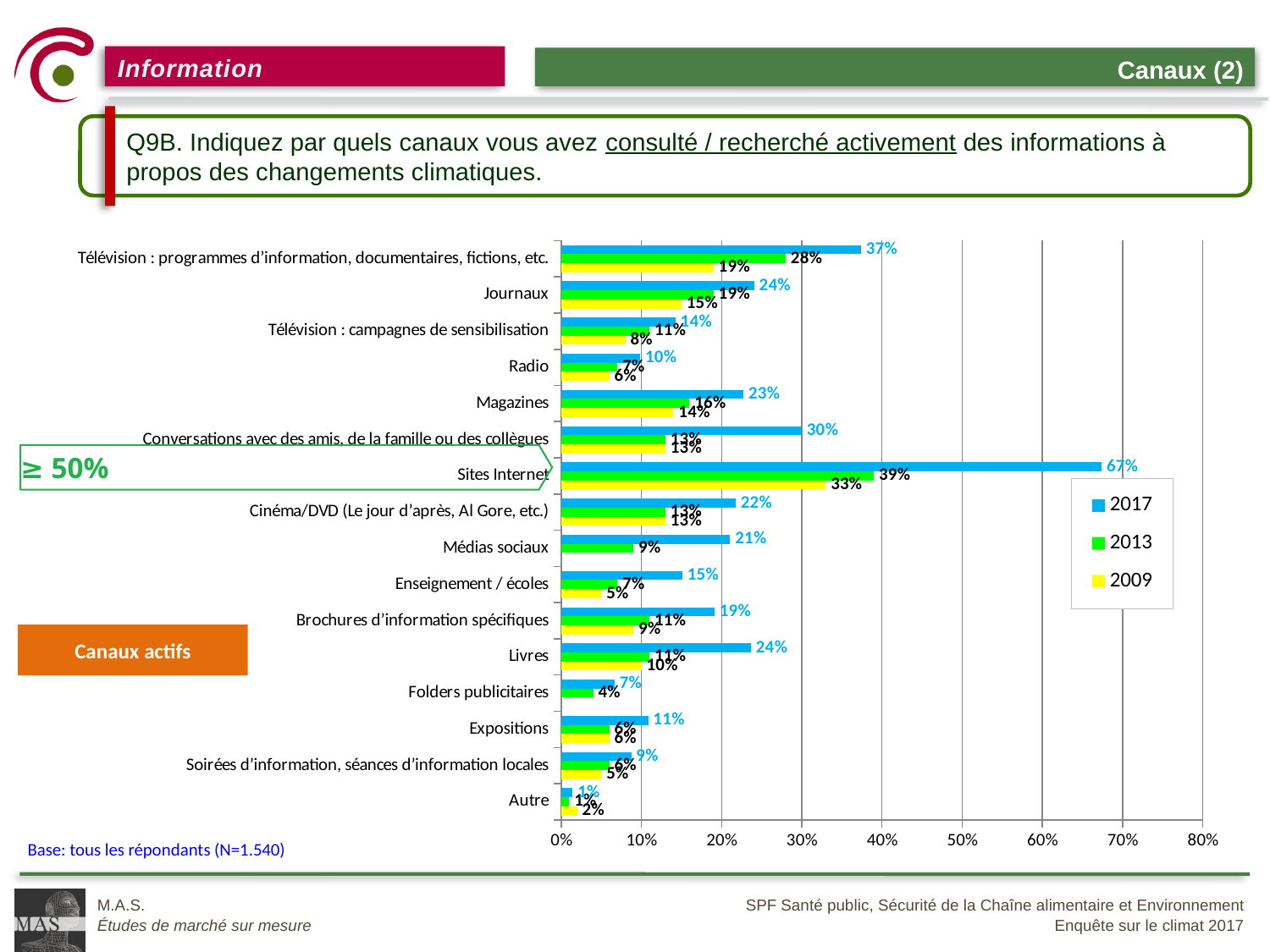
How many categories are shown on the chart? 16 What kind of chart is shown on the slide? Bar chart What is the 2013 value for Télévision : programmes d'information, documentaires, fictions, etc.? 28% What is the difference between the 2017 and 2013 values for Sites Internet? 28 percentage points Is the 2017 value for Télévision : programmes d'information, documentaires, fictions, etc. greater or less than 30%? greater Which has the larger 2017 value: Magazines or Conversations avec des amis, de la famille ou des collègues? Conversations avec des amis, de la famille ou des collègues What is the 2009 value for Journaux? 15% What is the 2017 value for Sites Internet? 67% How many series does the legend list? 3 Which category has the highest 2017 value? Sites Internet Which category has the lowest 2017 value? Autre Which years are listed in the chart legend? 2017, 2013, 2009